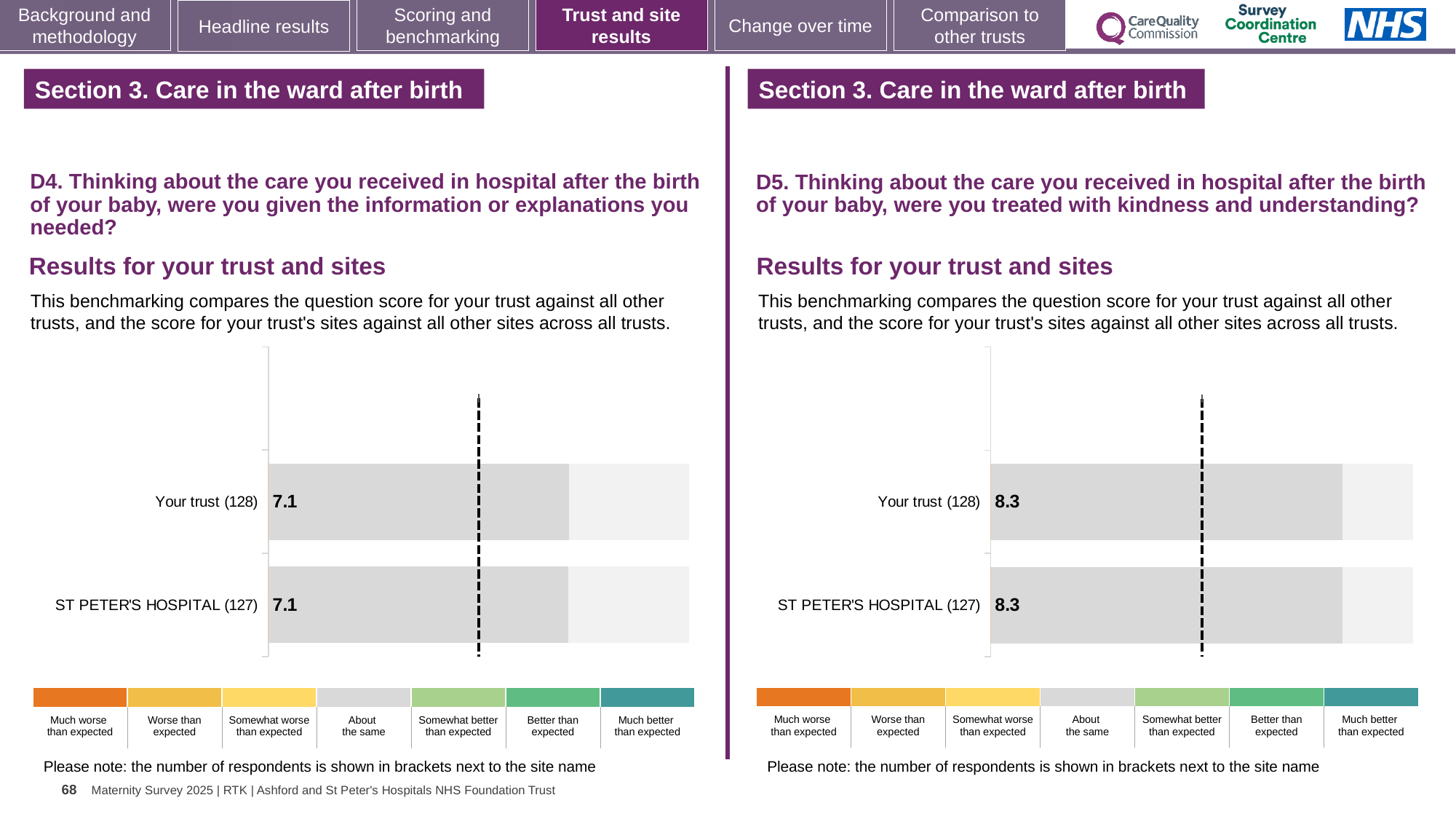
How many rating categories does the colour key below the D5 chart on the right list? 7 How many respondents are shown in brackets for ST PETER'S HOSPITAL in the D4 chart on the left? 127 What kind of chart is used for the D4 results on the left? Bar chart How many bars are plotted in the D4 chart on the left? 2 In the D4 chart on the left, what is the difference between the score for Your trust and the score for ST PETER'S HOSPITAL? 0.0 How many bars are plotted in the D5 chart on the right? 2 In the D5 chart on the right, what is the score for ST PETER'S HOSPITAL (127)? 8.3 In the D4 chart on the left, what is the score for ST PETER'S HOSPITAL (127)? 7.1 In the D4 chart on the left, what is the score for Your trust (128)? 7.1 Is the score for Your trust in the D5 chart on the right greater or less than the score for Your trust in the D4 chart on the left? greater In the D5 chart on the right, what is the score for Your trust (128)? 8.3 In the D5 chart on the right, what is the difference between the score for Your trust and the score for ST PETER'S HOSPITAL? 0.0